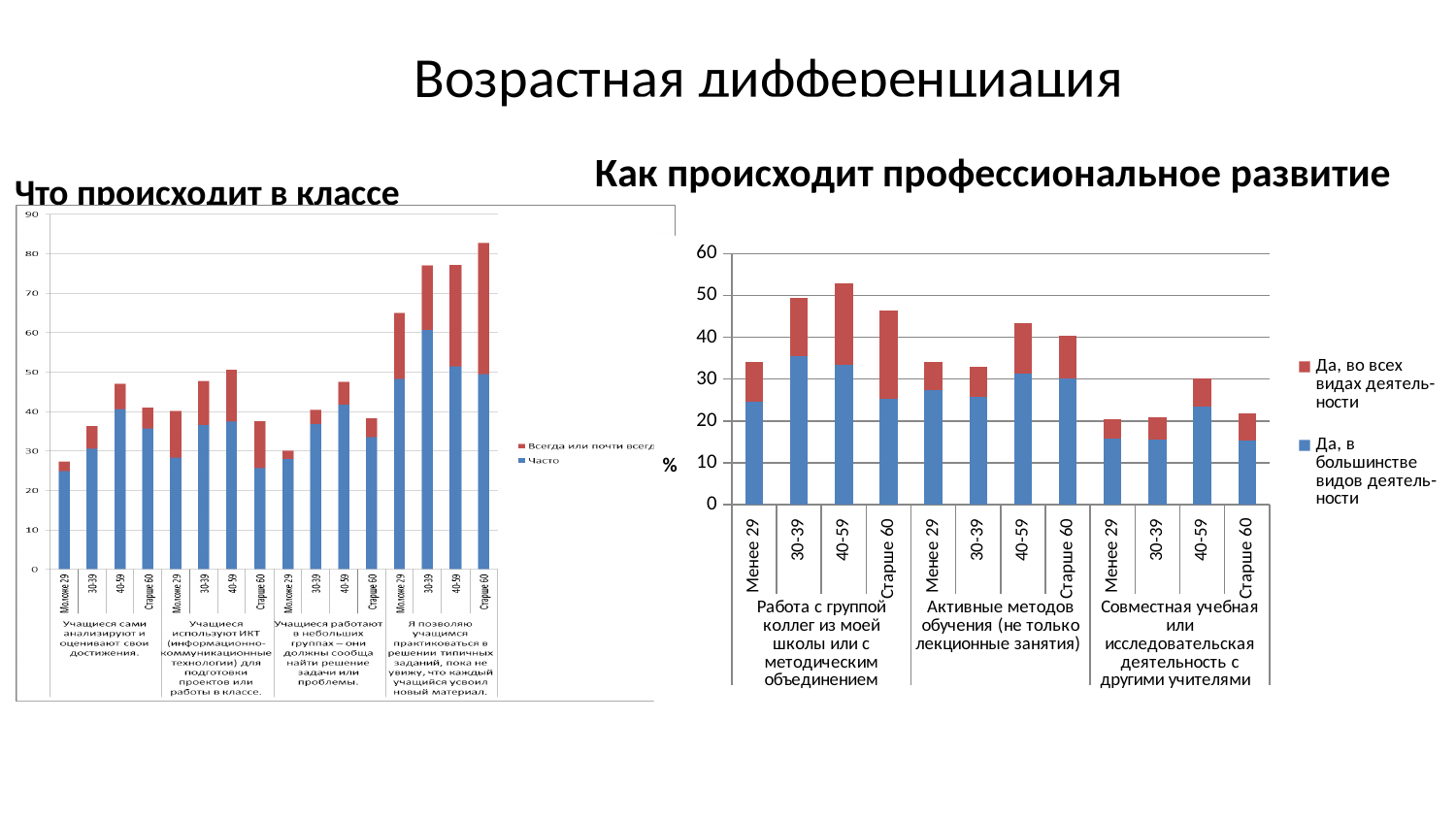
On the chart titled "Что происходит в классе", is the total for Моложе 29 in "Учащиеся сами анализируют и оценивают свои достижения" greater or less than 40? less On the chart titled "Как происходит профессиональное развитие", how many series does the legend list? 2 On the chart titled "Что происходит в классе", how many stacked bars are plotted in total? 16 On the chart titled "Как происходит профессиональное развитие", what unit is shown on the vertical axis? % On the chart titled "Как происходит профессиональное развитие", what kind of chart is shown? bar chart On the chart titled "Как происходит профессиональное развитие", how many stacked bars are plotted in total? 12 On the chart titled "Что происходит в классе", how many series does the legend list? 2 On the chart titled "Что происходит в классе", which bar has the highest total? Старше 60 in "Я позволяю учащимся практиковаться в решении типичных заданий, пока не увижу, что каждый учащийся усвоил новый материал" On the chart titled "Как происходит профессиональное развитие", is the total for Менее 29 in "Совместная учебная или исследовательская деятельность с другими учителями" greater or less than 30? less On the chart titled "Как происходит профессиональное развитие", is the total for 30-39 in "Работа с группой коллег из моей школы или с методическим объединением" greater or less than 40? greater On the chart titled "Как происходит профессиональное развитие", which bar has the highest total? 40-59 in "Работа с группой коллег из моей школы или с методическим объединением" On the chart titled "Как происходит профессиональное развитие", within "Активные методов обучения (не только лекционные занятия)", which has the larger total: 30-39 or 40-59? 40-59